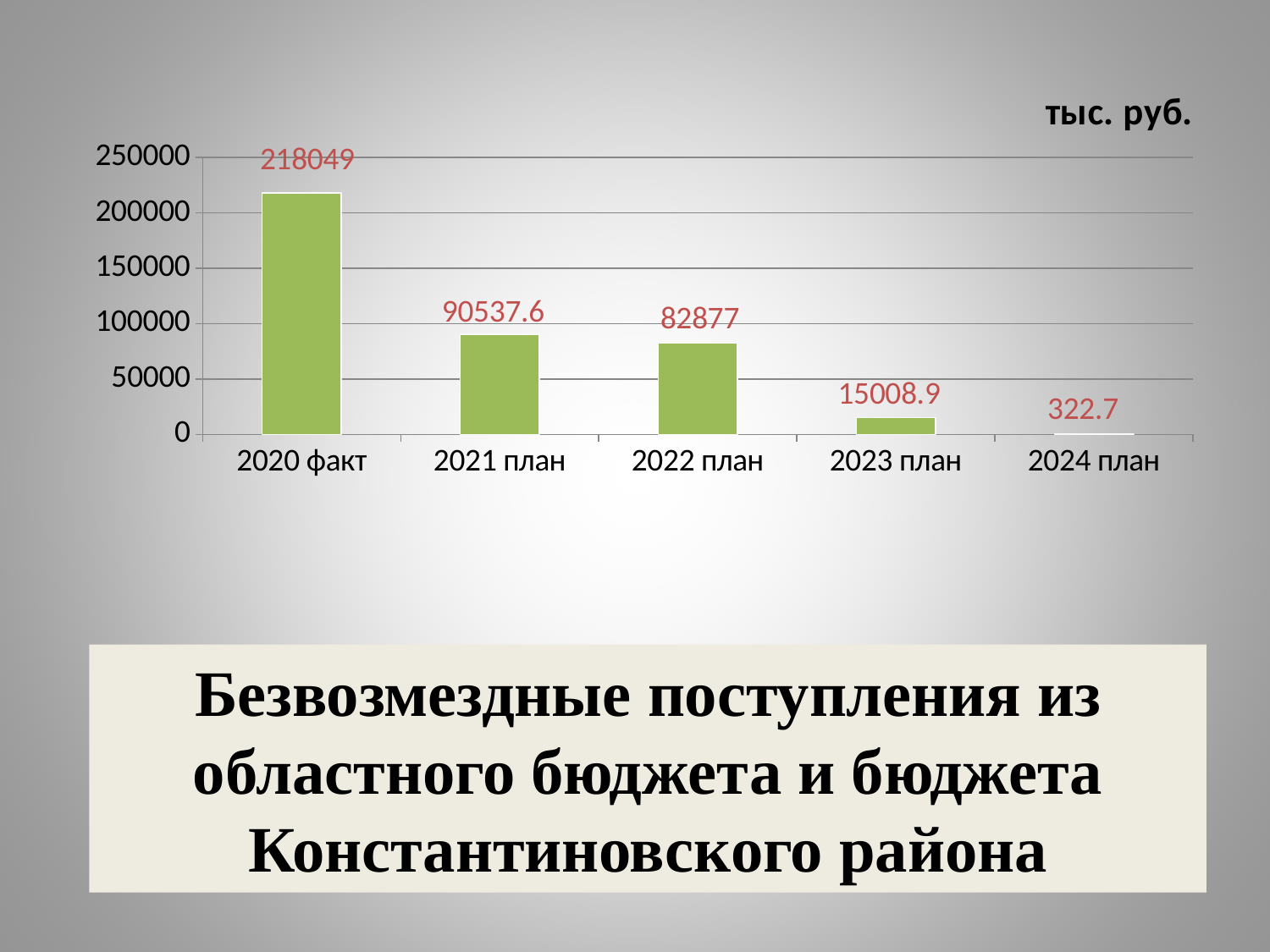
What is the value for 2024 план? 322.7 What is the value for 2020 факт? 218049 Which category has the lowest value? 2024 план Which is larger, the value for 2022 план or the value for 2023 план? 2022 план What is the value for 2021 план? 90537.6 What is the difference between the values for 2021 план and 2022 план? 7660.6 Do the values rise or fall from 2020 факт to 2024 план? fall What is the difference between the values for 2020 факт and 2021 план? 127511.4 What is the value for 2023 план? 15008.9 How many categories are shown on the x axis? 5 Which category has the highest value? 2020 факт What kind of chart is shown on the slide? bar chart